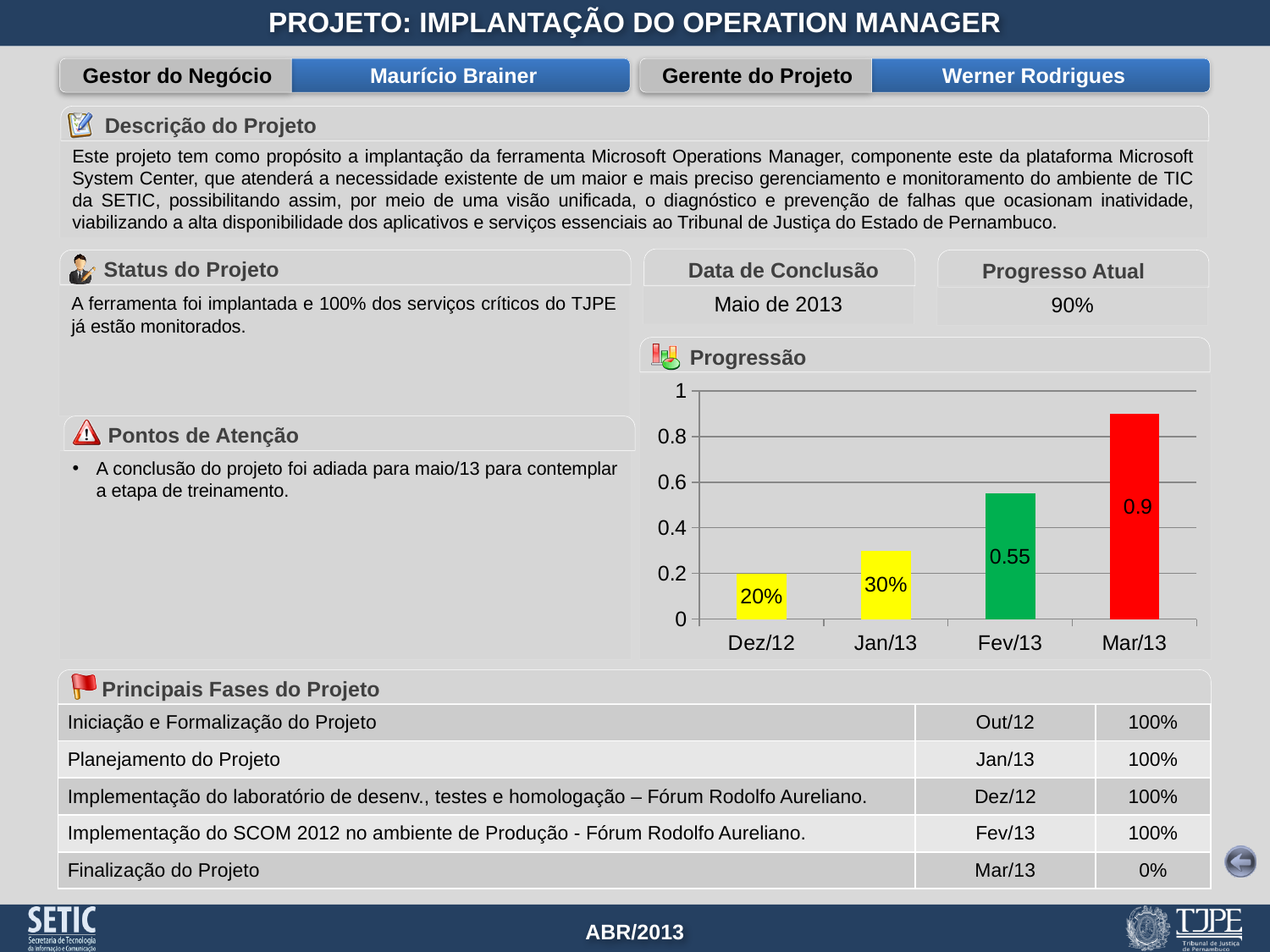
What is the value shown for Jan/13 in the Progressão chart? 30% In the Progressão chart, what is the difference between the values for Mar/13 and Fev/13? 0.35 Which month has the lowest bar in the Progressão chart? Dez/12 Do the values in the Progressão chart rise or fall from Dez/12 to Mar/13? rise Which month has the highest bar in the Progressão chart? Mar/13 What type of chart is shown under "Progressão"? bar chart How many months are plotted on the x axis of the Progressão chart? 4 What is the value shown for Fev/13 in the Progressão chart? 0.55 What colour is the bar for Mar/13 in the Progressão chart? red What is the value shown for Dez/12 in the Progressão chart? 20% What is the value shown for Mar/13 in the Progressão chart? 0.9 In the Progressão chart, which is larger, the bar for Fev/13 or the bar for Jan/13? Fev/13